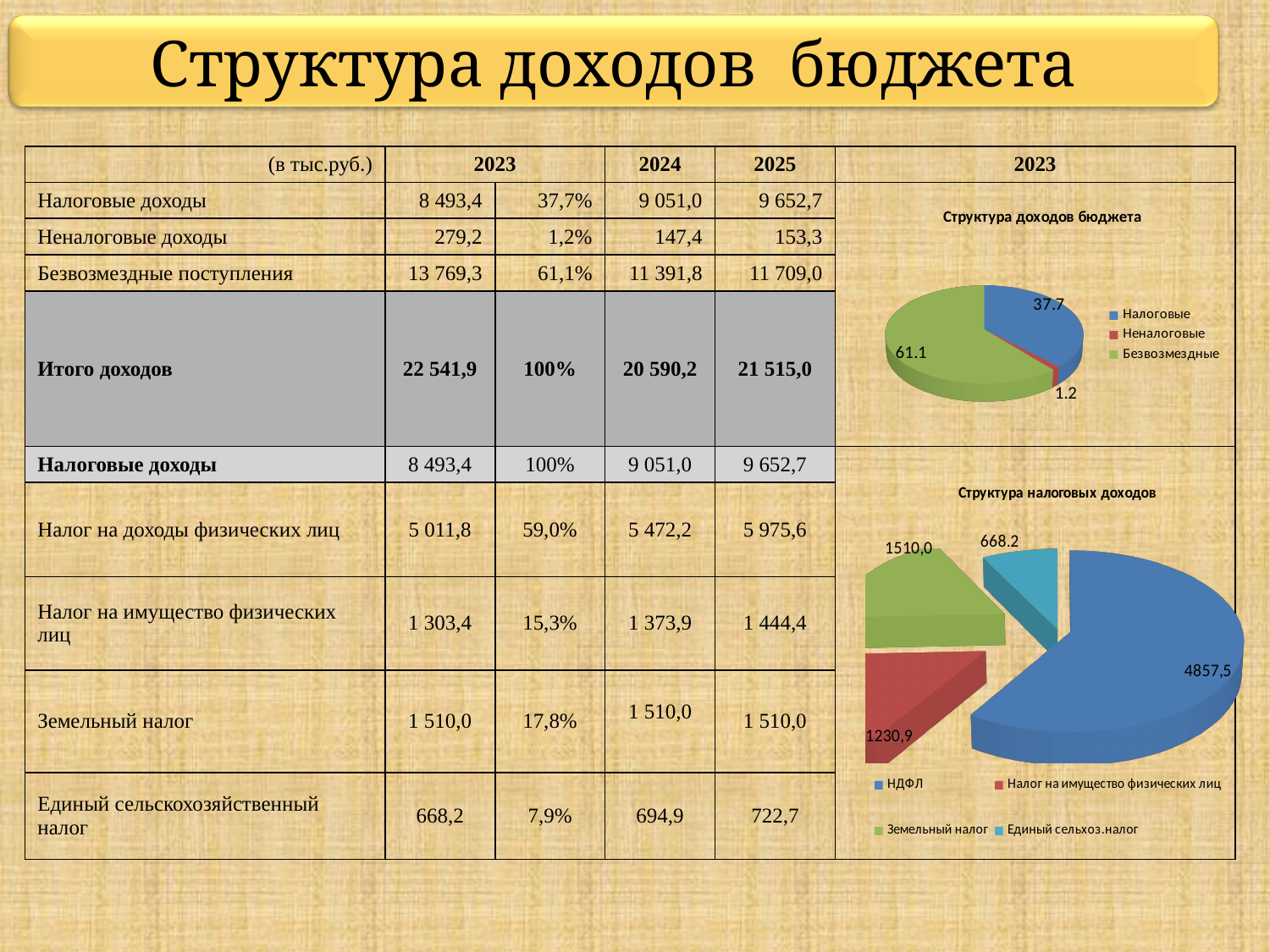
In the chart titled "Структура доходов бюджета", which category has the smallest slice? Неналоговые In the chart titled "Структура налоговых доходов", which is larger: Земельный налог or Налог на имущество физических лиц? Земельный налог In the chart titled "Структура доходов бюджета", what value is shown for the Безвозмездные slice? 61.1 In the chart titled "Структура доходов бюджета", how many categories does the legend list? 3 In the chart titled "Структура налоговых доходов", what value is shown for Единый сельхоз.налог? 668.2 In the chart titled "Структура налоговых доходов", which category has the largest slice? НДФЛ In the chart titled "Структура доходов бюджета", which category has the largest slice? Безвозмездные What type of chart is the one titled "Структура налоговых доходов"? Pie chart In the chart titled "Структура налоговых доходов", what value is shown for Земельный налог? 1510,0 In the chart titled "Структура налоговых доходов", how many categories does the legend list? 4 In the chart titled "Структура доходов бюджета", what value is shown for the Налоговые slice? 37.7 In the chart titled "Структура налоговых доходов", what value is shown for НДФЛ? 4857,5